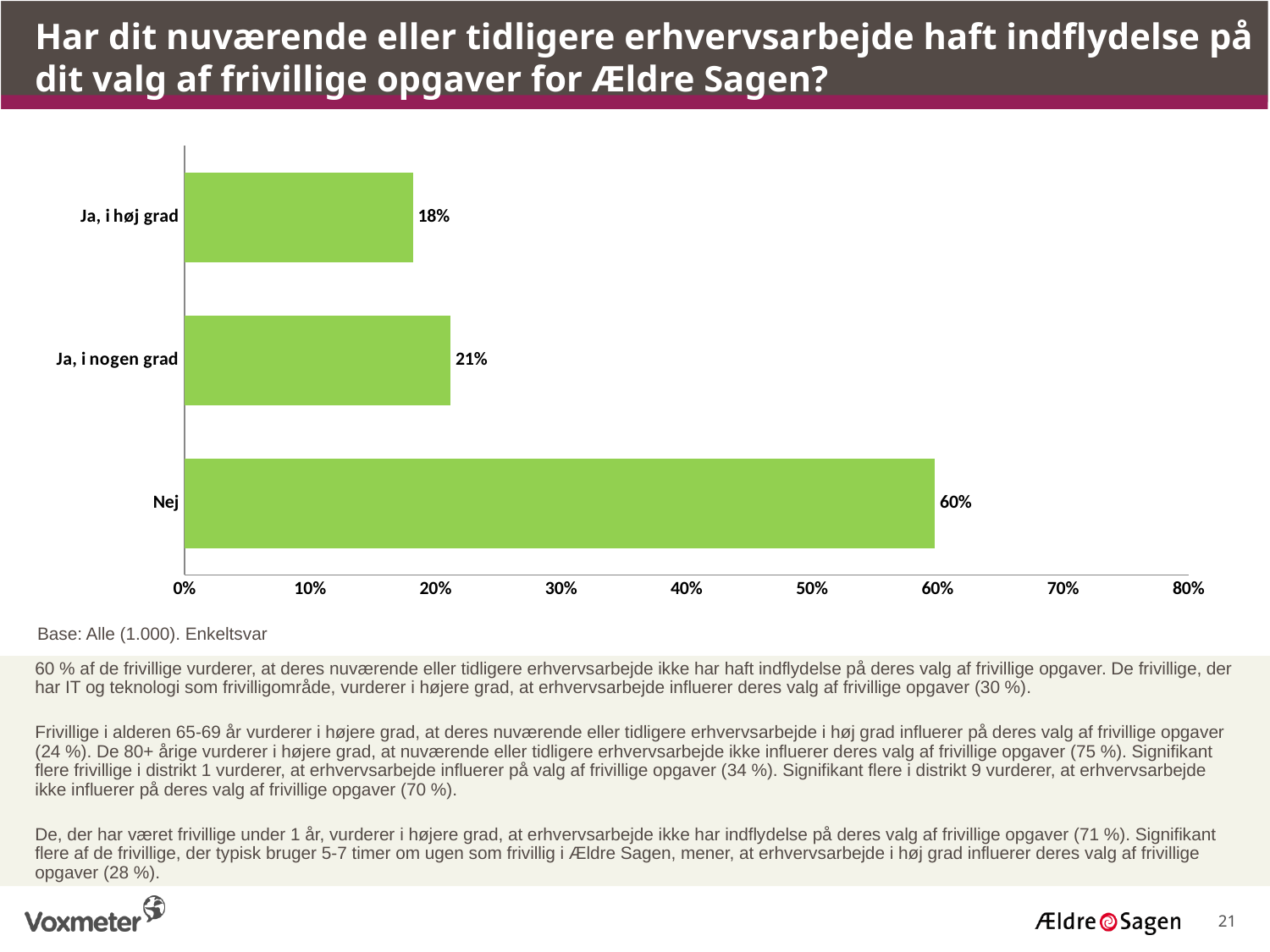
What is the highest value shown on the x axis? 80% What is the value for "Ja, i nogen grad"? 21% Which is larger, the value for "Ja, i nogen grad" or the value for "Ja, i høj grad"? Ja, i nogen grad How many categories are shown in the chart? 3 Which category has the highest value? Nej What is the value for "Ja, i høj grad"? 18% What is the difference between the values for "Ja, i nogen grad" and "Ja, i høj grad"? 3% What kind of chart is shown on the slide? Bar chart What is the difference between the values for "Nej" and "Ja, i nogen grad"? 39% Is the value for "Nej" greater or less than 50%? greater What is the value for "Nej"? 60% Which category has the lowest value? Ja, i høj grad